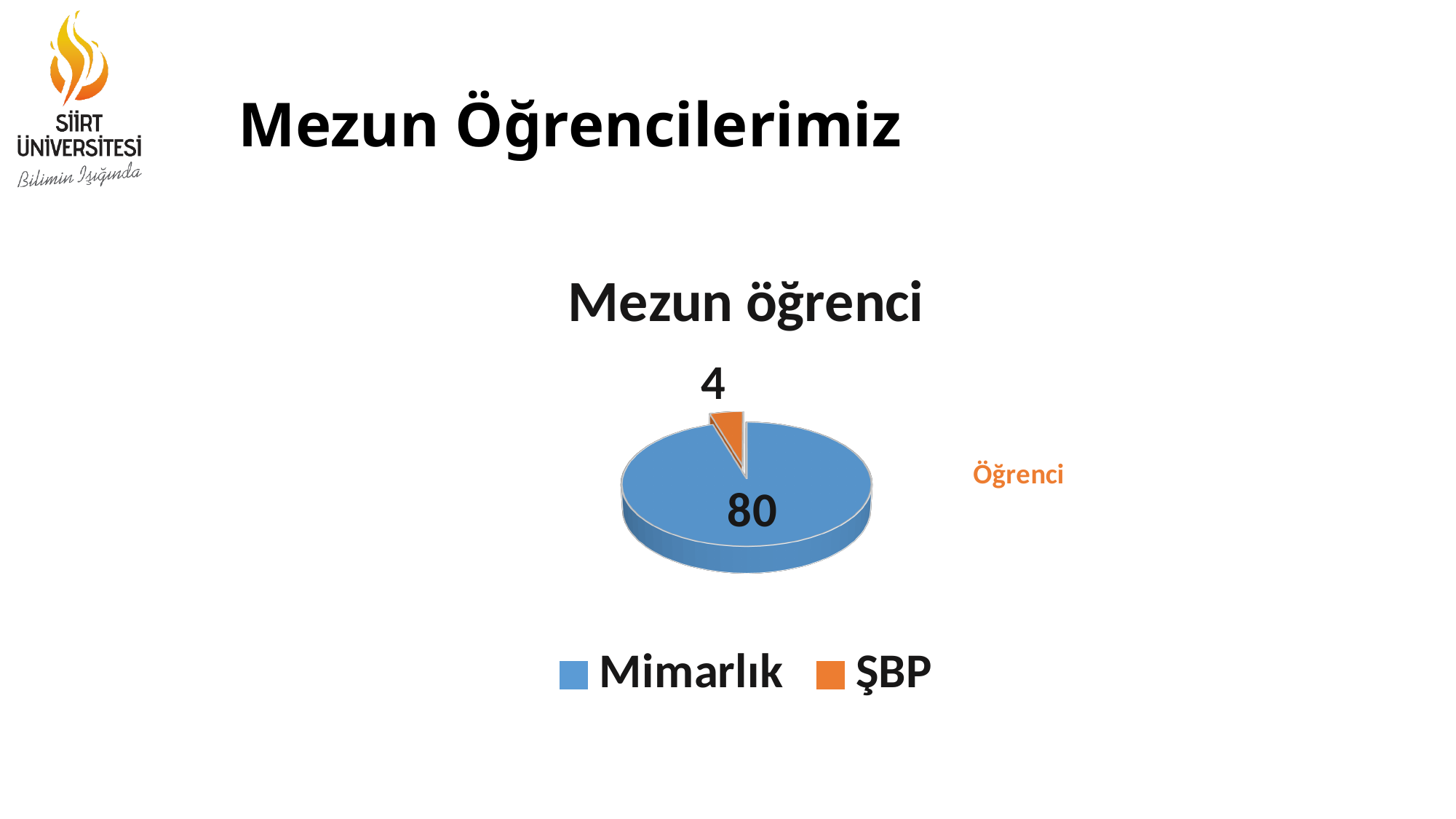
Which category has the smallest slice in the pie chart? ŞBP What is the value for ŞBP in the pie chart? 4 What is the title of the chart on the slide? Mezun öğrenci How many slices does the pie chart have? 2 Which category has the largest slice in the pie chart? Mimarlık What kind of chart is shown on the slide? Pie chart How many entries does the legend of the pie chart list? 2 What colour is the ŞBP slice in the pie chart? Orange What is the value for Mimarlık in the pie chart? 80 Which is larger in the pie chart, Mimarlık or ŞBP? Mimarlık What is the total of all slices in the pie chart? 84 What is the difference between the Mimarlık and ŞBP values in the pie chart? 76